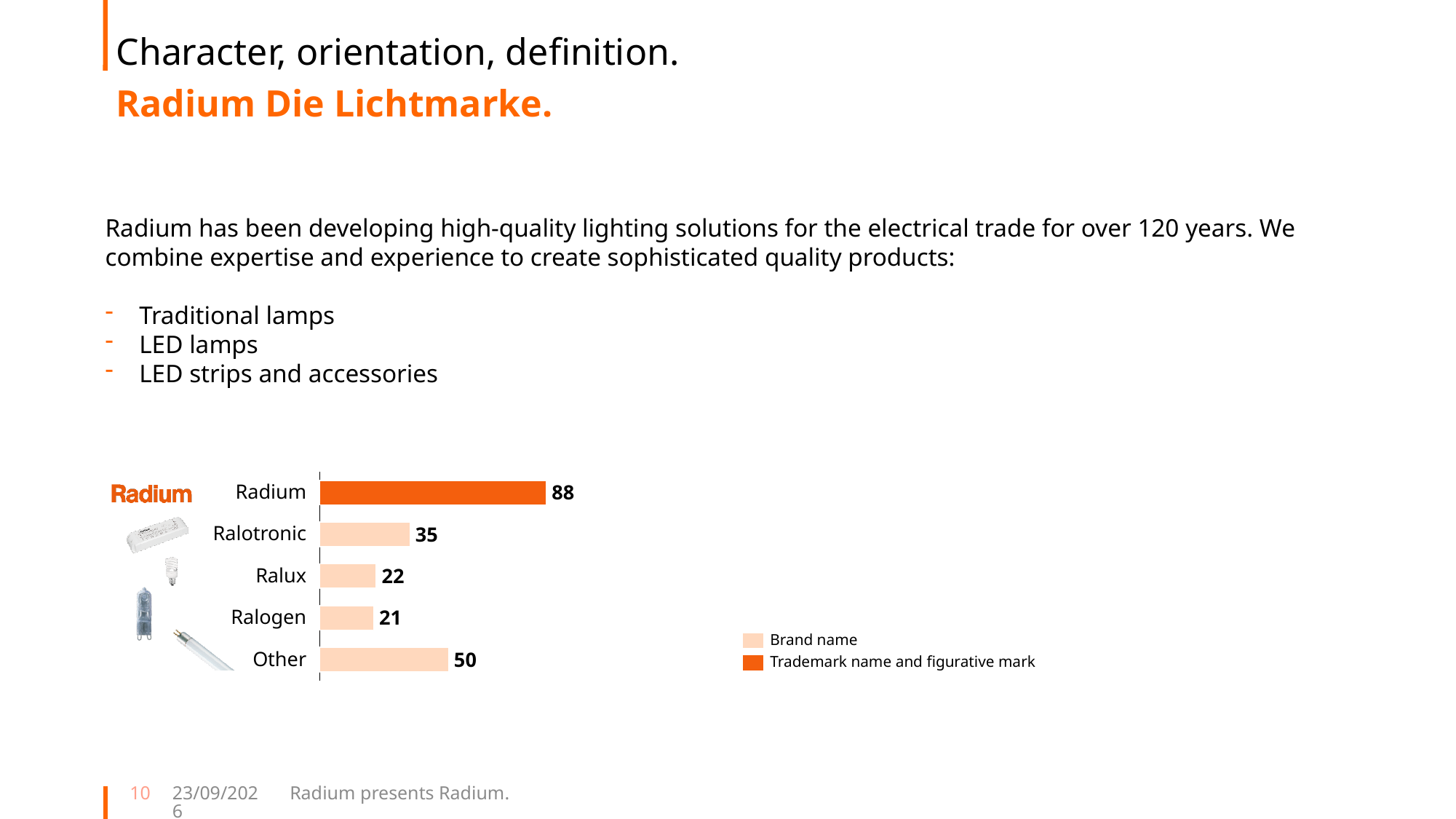
What kind of chart is shown on the slide? Bar chart What is the difference between the values for Ralux and Ralogen? 1 Which is larger, the value for Ralotronic or the value for Other? Other Which category has the highest value? Radium Which category has the lowest value? Ralogen Which legend entry does the dark orange bar represent? Trademark name and figurative mark What is the difference between the values for Radium and Other? 38 How many categories are shown in the chart? 5 What is the value for Radium? 88 How many entries does the legend list? 2 What is the value for Other? 50 What is the value for Ralotronic? 35